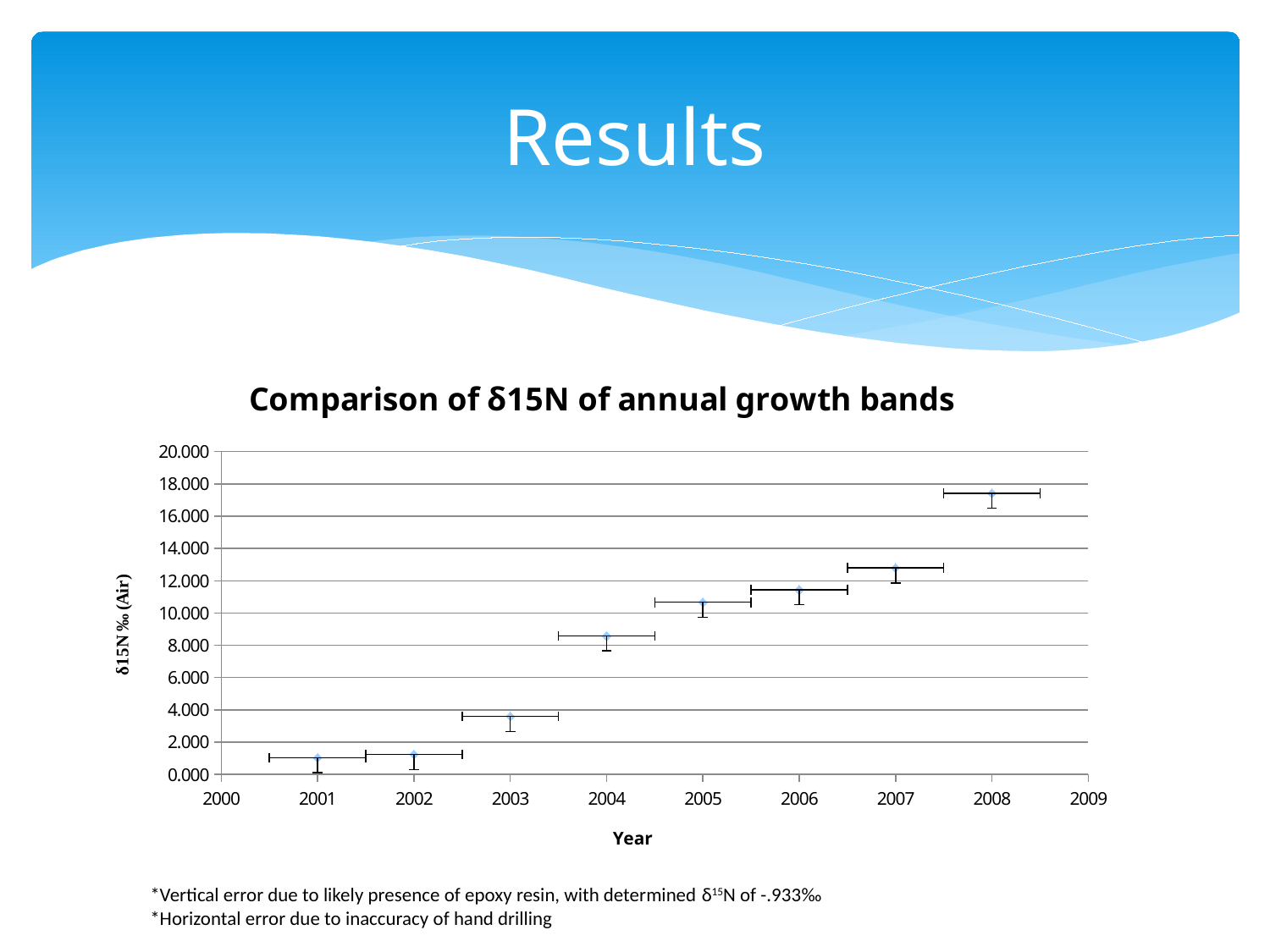
What is the title of the chart? Comparison of δ15N of annual growth bands What kind of chart is shown on the slide? scatter chart How many data points are plotted on the chart? 8 Which year has the highest δ15N value? 2008 Is the value for 2007 greater or less than 12.000? greater Is the value for 2001 greater or less than 2.000? less What is the label on the x axis of the chart? Year Is the value for 2008 greater or less than 16.000? greater Do the δ15N values generally rise or fall from 2001 to 2008? rise Which is larger, the value for 2005 or the value for 2003? 2005